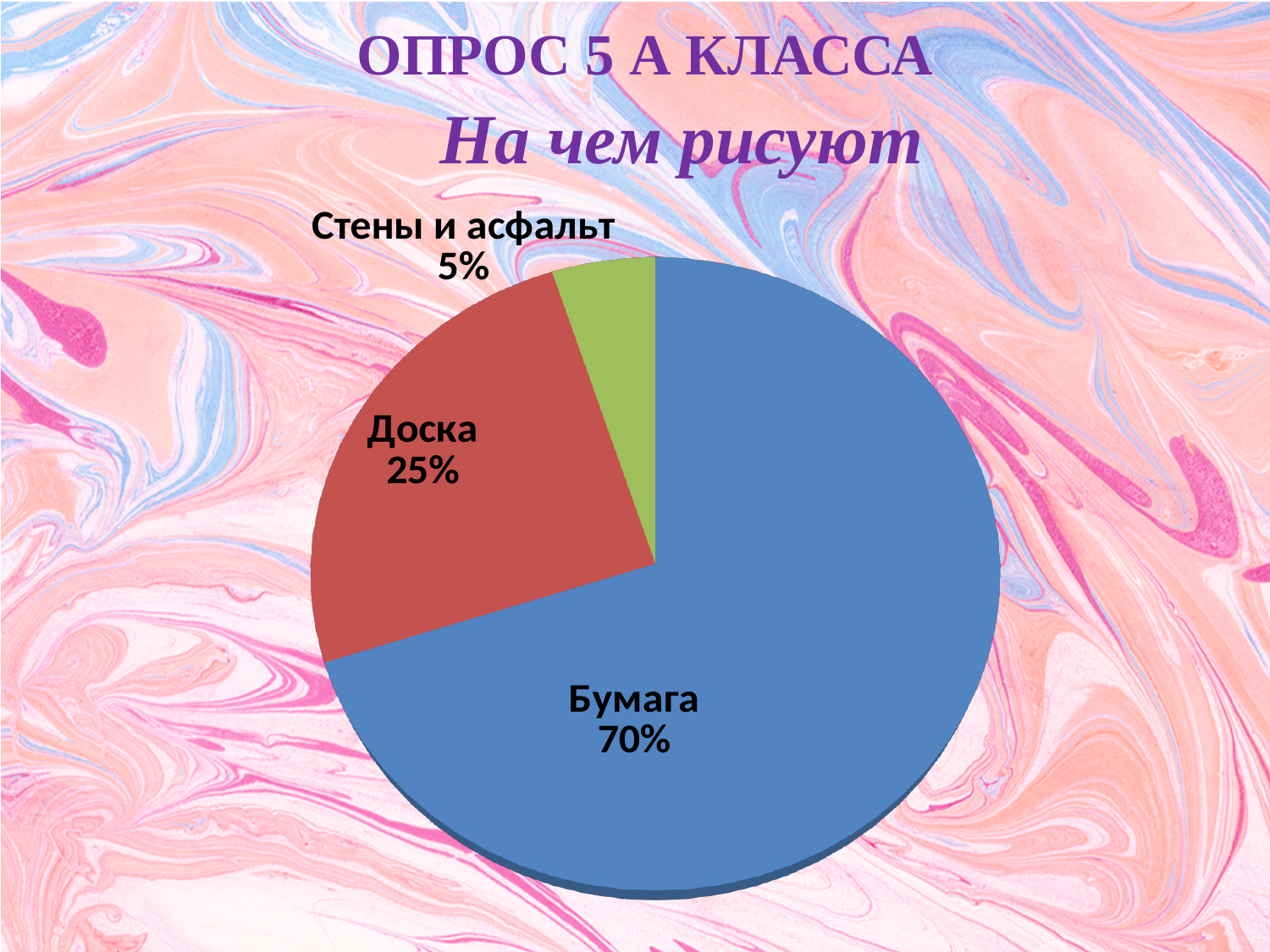
Which is larger, the share for Доска or the share for Стены и асфальт? Доска How many categories are shown in the pie chart? 3 What share of the pie does Стены и асфальт have? 5% What is the difference between the shares of Доска and Стены и асфальт? 20% What share of the pie does Доска have? 25% What kind of chart is shown on the slide? pie chart What is the difference between the shares of Бумага and Доска? 45% What share of the pie does Бумага have? 70% Which category has the smallest slice of the pie? Стены и асфальт What is the title of the chart on the slide? На чем рисуют What colour is the slice for Бумага? blue Which category has the largest slice of the pie? Бумага